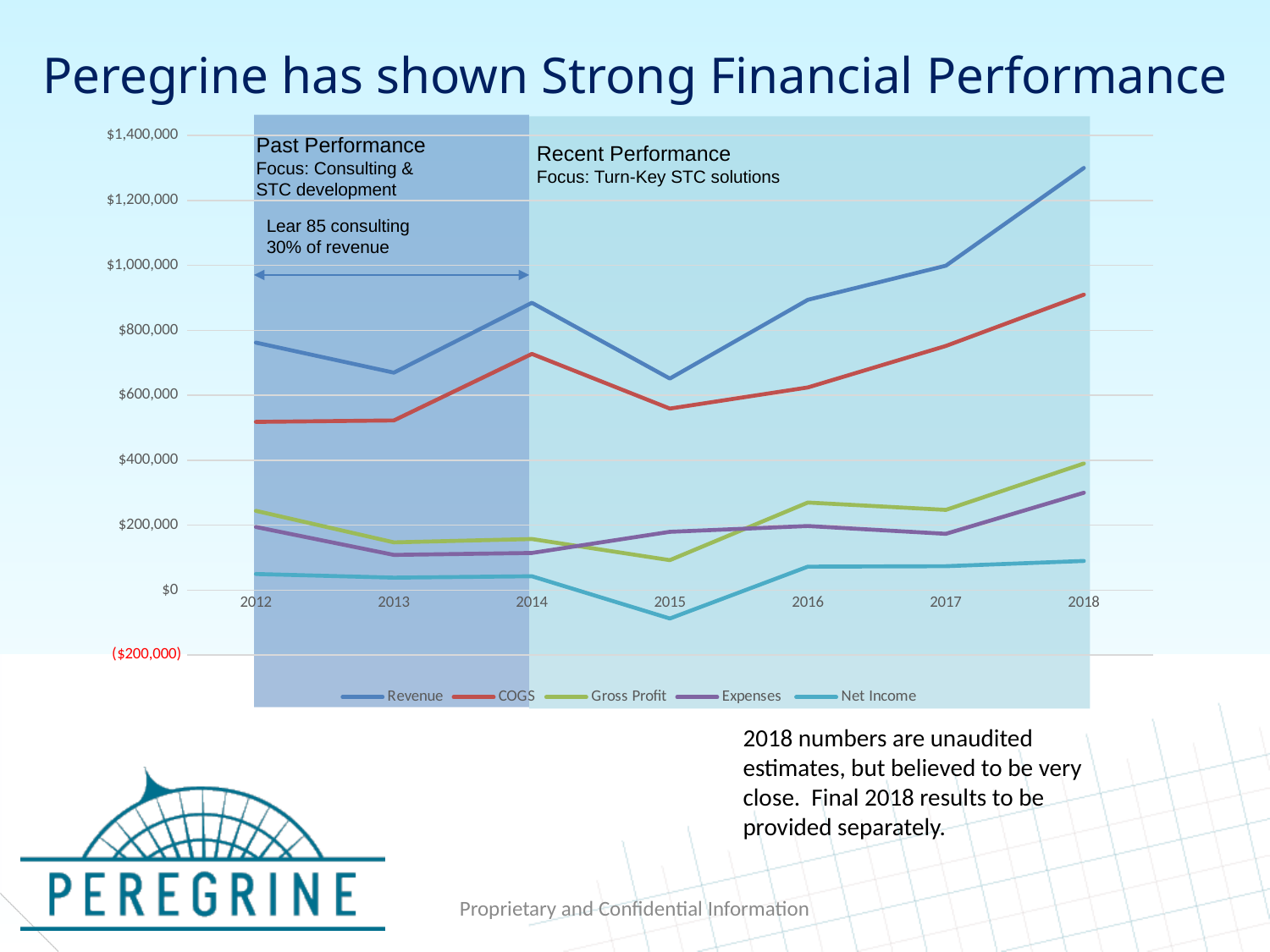
Is the Revenue value for 2018 greater or less than $1,200,000? greater Is the Net Income value for 2015 greater or less than $0? less Is the Revenue value for 2012 greater or less than $800,000? less How many series does the chart legend list? 5 In which year is Revenue highest? 2018 Does Revenue rise or fall from 2015 to 2018? Rise Which series is drawn in red on the chart? COGS In 2018, which is larger: Gross Profit or Expenses? Gross Profit How many years are plotted along the x axis of the chart? 7 What kind of chart is shown on the slide? Line chart In which year is Net Income lowest? 2015